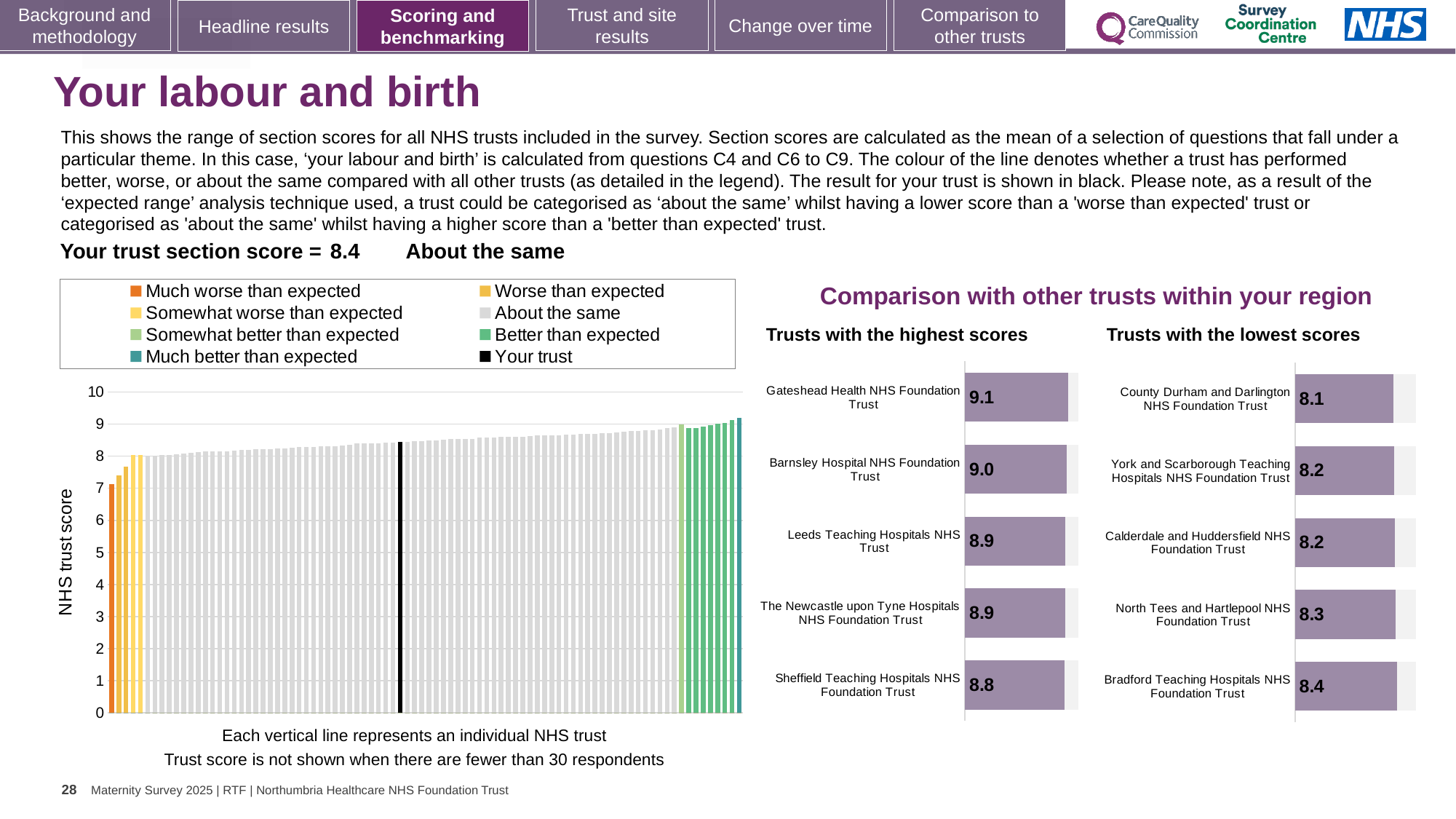
In the NHS trust score chart, is the value of the black 'Your trust' bar greater or less than 8? greater In the NHS trust score chart, do the values rise or fall from left to right along the x axis? Rise What kind of chart is the NHS trust score chart on the left? Bar chart In the 'Trusts with the highest scores' chart, what is the difference between the scores of Gateshead Health NHS Foundation Trust and Sheffield Teaching Hospitals NHS Foundation Trust? 0.3 In the 'Trusts with the highest scores' chart, which trust has the highest score? Gateshead Health NHS Foundation Trust In the 'Trusts with the highest scores' chart, what is the score for Gateshead Health NHS Foundation Trust? 9.1 In the 'Trusts with the lowest scores' chart, what is the score for York and Scarborough Teaching Hospitals NHS Foundation Trust? 8.2 How many trusts are listed in the 'Trusts with the highest scores' chart? 5 In the 'Trusts with the lowest scores' chart, what is the score for Bradford Teaching Hospitals NHS Foundation Trust? 8.4 In the 'Trusts with the lowest scores' chart, which trust has the lowest score? County Durham and Darlington NHS Foundation Trust How many entries does the legend of the NHS trust score chart list? 8 In the 'Trusts with the lowest scores' chart, which has the larger score: North Tees and Hartlepool NHS Foundation Trust or County Durham and Darlington NHS Foundation Trust? North Tees and Hartlepool NHS Foundation Trust